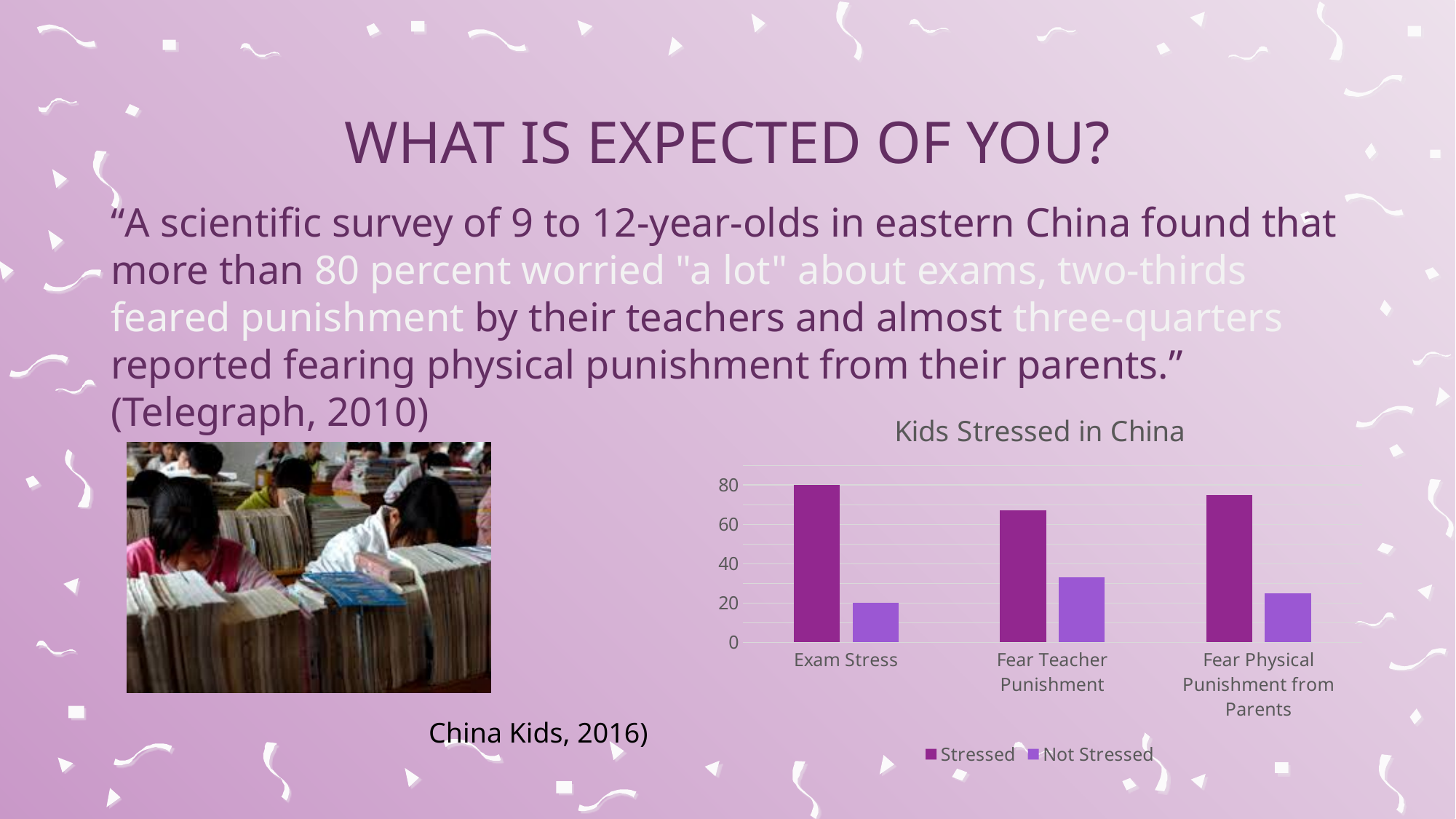
How many series does the chart legend list? 2 What is the title of the chart? Kids Stressed in China Is the Stressed value for Fear Teacher Punishment greater or less than 60? greater How many categories are shown on the x axis of the chart? 3 Is the Not Stressed value for Fear Physical Punishment from Parents greater or less than 40? less Which category has the highest Not Stressed value? Fear Teacher Punishment What is the Stressed value for Exam Stress? 80 Which category has the lowest Stressed value? Fear Teacher Punishment What type of chart is shown on the slide? bar chart What is the Not Stressed value for Exam Stress? 20 Which category has the highest Stressed value? Exam Stress Which is larger: the Stressed value for Fear Physical Punishment from Parents or the Stressed value for Fear Teacher Punishment? Fear Physical Punishment from Parents